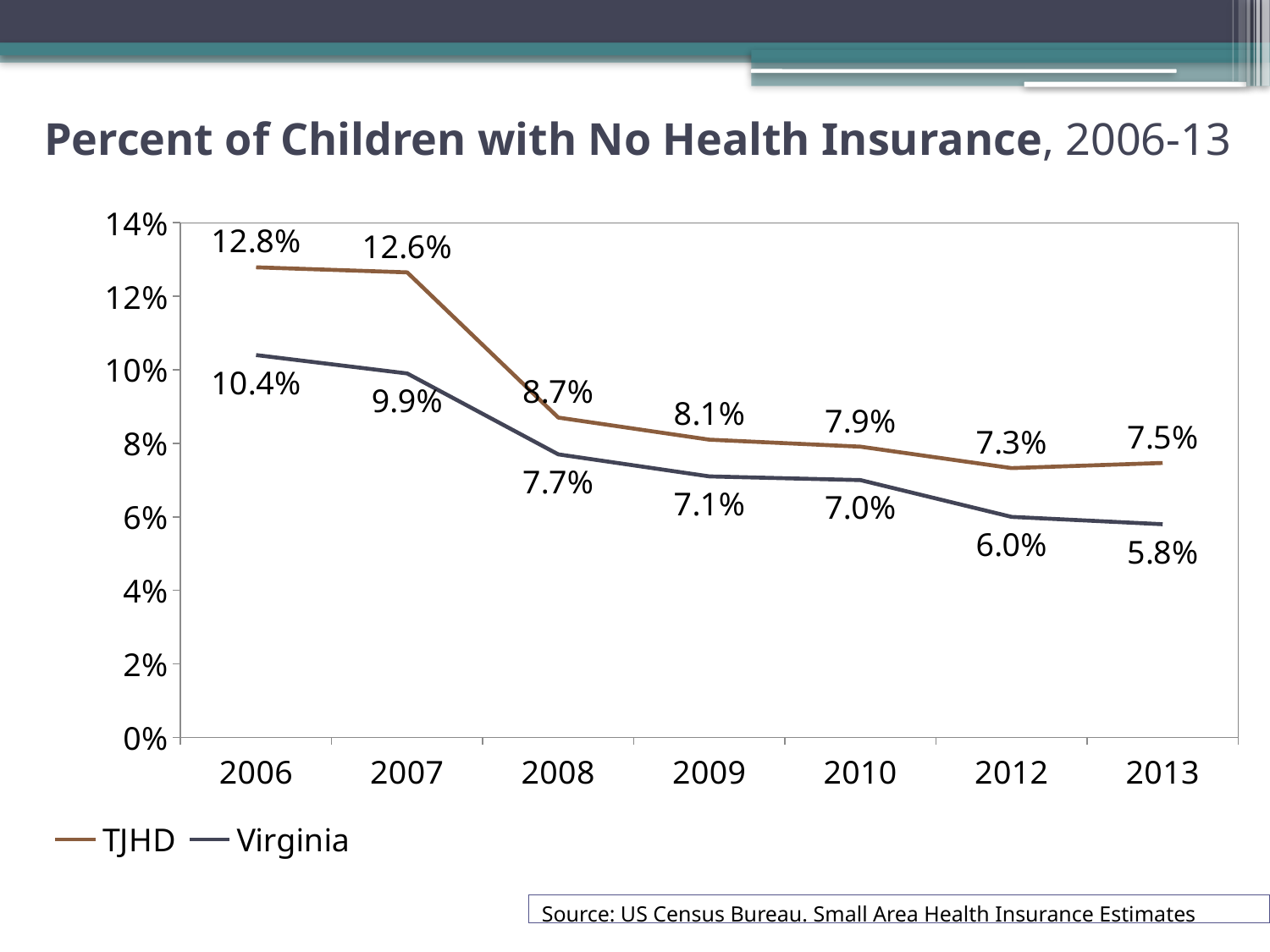
Which series has the larger value in 2010, TJHD or Virginia? TJHD How many series does the legend list? 2 In which year is the Virginia value lowest? 2013 Is the TJHD value for 2007 greater or less than 12%? greater What is the TJHD value for 2012? 7.3% What is the TJHD value for 2006? 12.8% Does the Virginia series generally rise or fall from 2006 to 2013? Fall How many years are shown on the x axis? 7 What kind of chart is shown on the slide? Line chart What is the Virginia value for 2013? 5.8% What is the difference between the TJHD and Virginia values in 2008? 1.0% In which year is the TJHD value highest? 2006